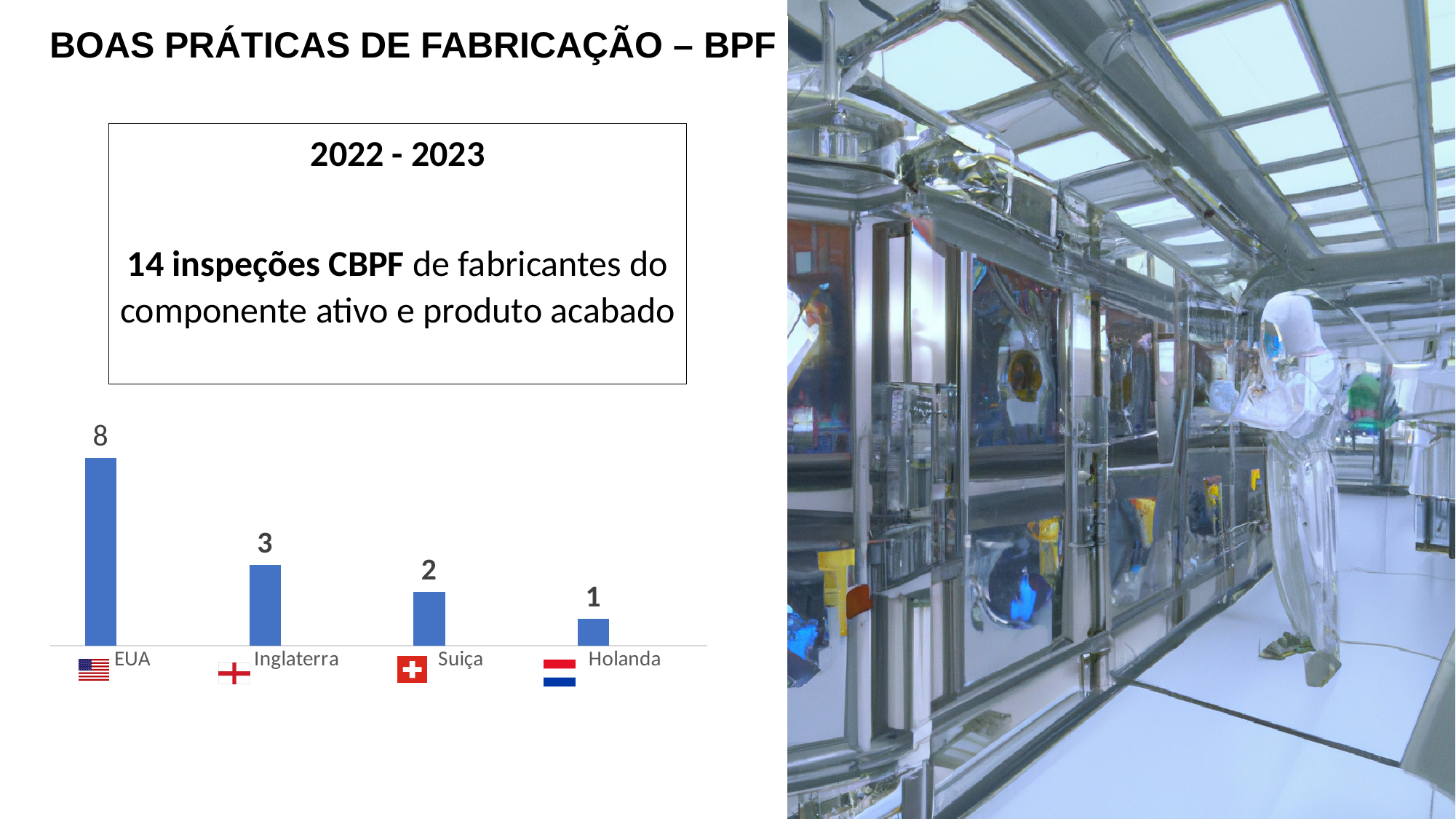
What is the value for Suiça? 2 How many categories are shown in the chart? 4 What is the total of the four values shown in the chart? 14 Which is larger, the value for Suiça or the value for Holanda? Suiça What is the value for EUA? 8 What is the value for Holanda? 1 Which category has the lowest value? Holanda What is the difference between the values for EUA and Inglaterra? 5 What kind of chart is shown on the slide? bar chart Do the values rise or fall from left to right along the x axis? fall What is the value for Inglaterra? 3 Which category has the highest value? EUA